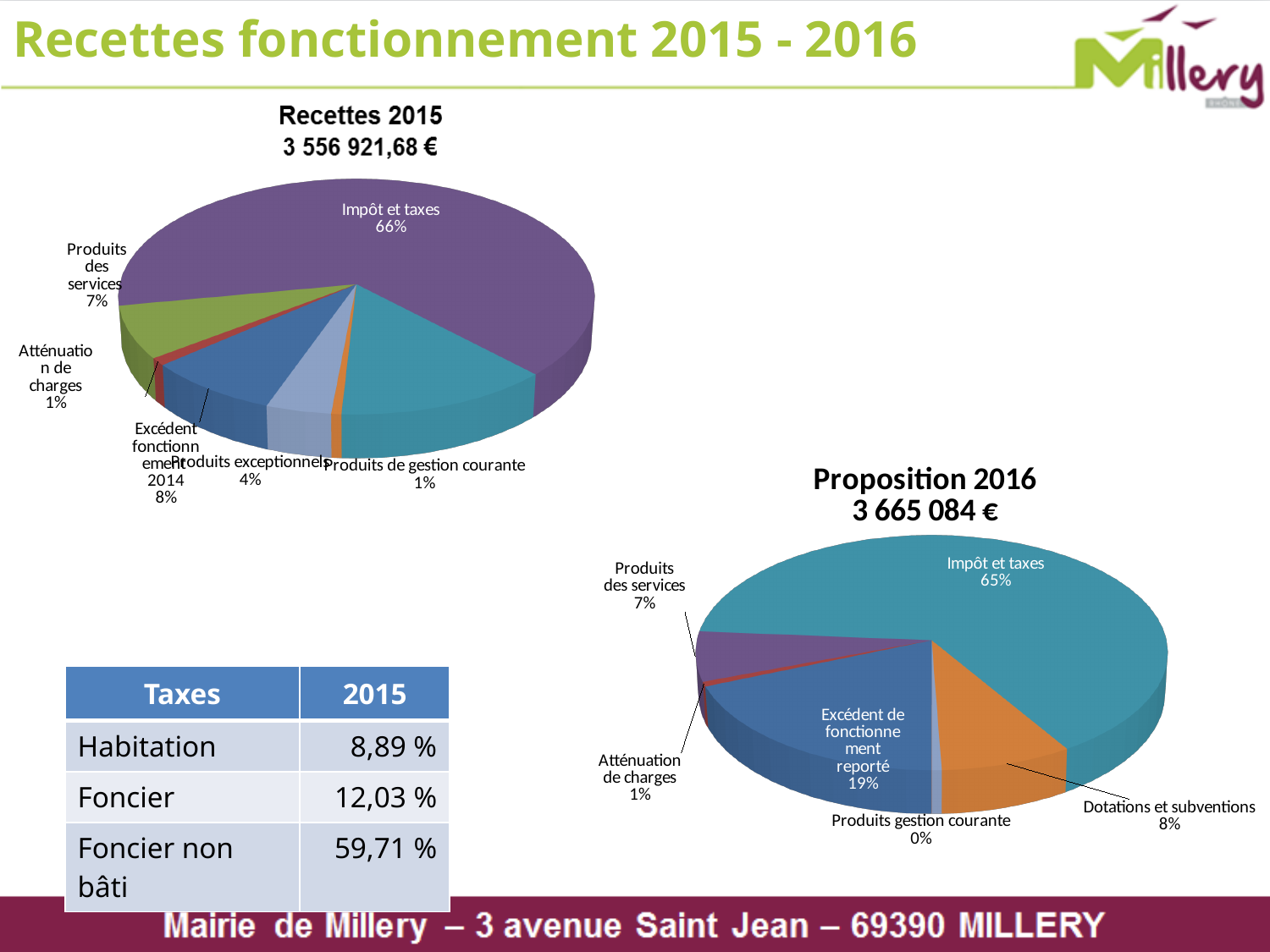
In the "Proposition 2016" chart, what share is shown for Impôt et taxes? 65% In the "Proposition 2016" chart, what share is shown for Dotations et subventions? 8% How many slices does the "Proposition 2016" pie chart have? 6 In the "Proposition 2016" chart, which is larger: Produits des services or Dotations et subventions? Dotations et subventions What kind of chart is the "Recettes 2015" chart? Pie chart What total amount is shown under the title of the "Proposition 2016" chart? 3 665 084 € In the "Recettes 2015" chart, what share is shown for Impôt et taxes? 66% In the "Proposition 2016" chart, which category has the smallest share? Produits gestion courante In the "Recettes 2015" chart, what share is shown for Produits exceptionnels? 4% By how many percentage points does the Impôt et taxes share in the "Recettes 2015" chart exceed that in the "Proposition 2016" chart? 1 percentage point In the "Proposition 2016" chart, what share is shown for Excédent de fonctionnement reporté? 19% In the "Proposition 2016" chart, which category has the largest share? Impôt et taxes